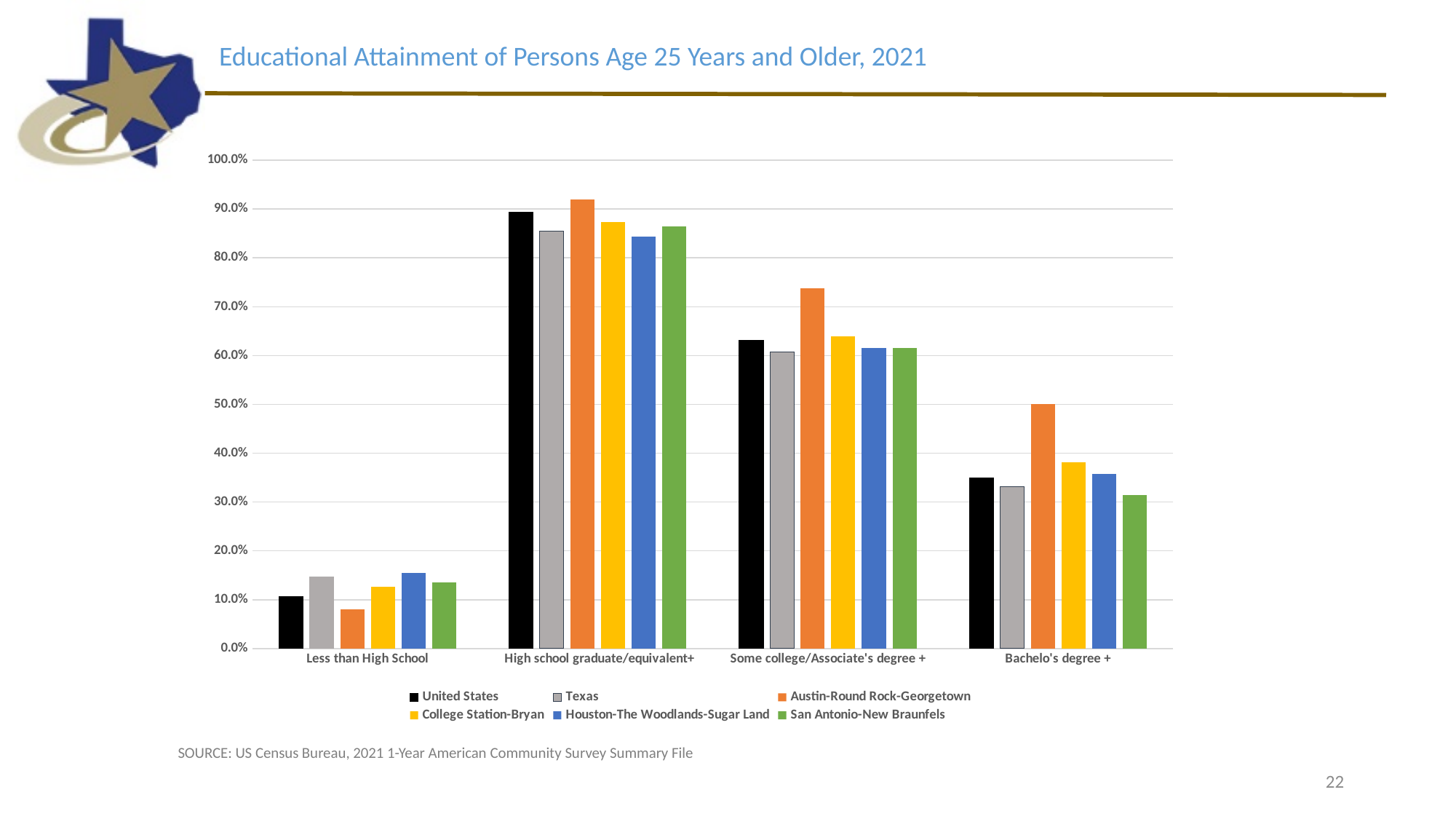
Which area has the lowest value for Bachelo's degree +? San Antonio-New Braunfels How many educational attainment categories are shown on the x axis? 4 Is the value for Texas in Bachelo's degree + greater or less than 40.0%? less What kind of chart is shown on the slide? Bar chart Is the value for United States in Some college/Associate's degree + greater or less than 60.0%? greater In the Less than High School category, which is larger: Houston-The Woodlands-Sugar Land or College Station-Bryan? Houston-The Woodlands-Sugar Land How many series does the legend list? 6 Which area has the lowest value for Less than High School? Austin-Round Rock-Georgetown Which area has the highest value for Bachelo's degree +? Austin-Round Rock-Georgetown Which area has the highest value for Some college/Associate's degree +? Austin-Round Rock-Georgetown In the Bachelo's degree + category, which is larger: College Station-Bryan or San Antonio-New Braunfels? College Station-Bryan Is the value for Austin-Round Rock-Georgetown in High school graduate/equivalent+ greater or less than 90.0%? greater